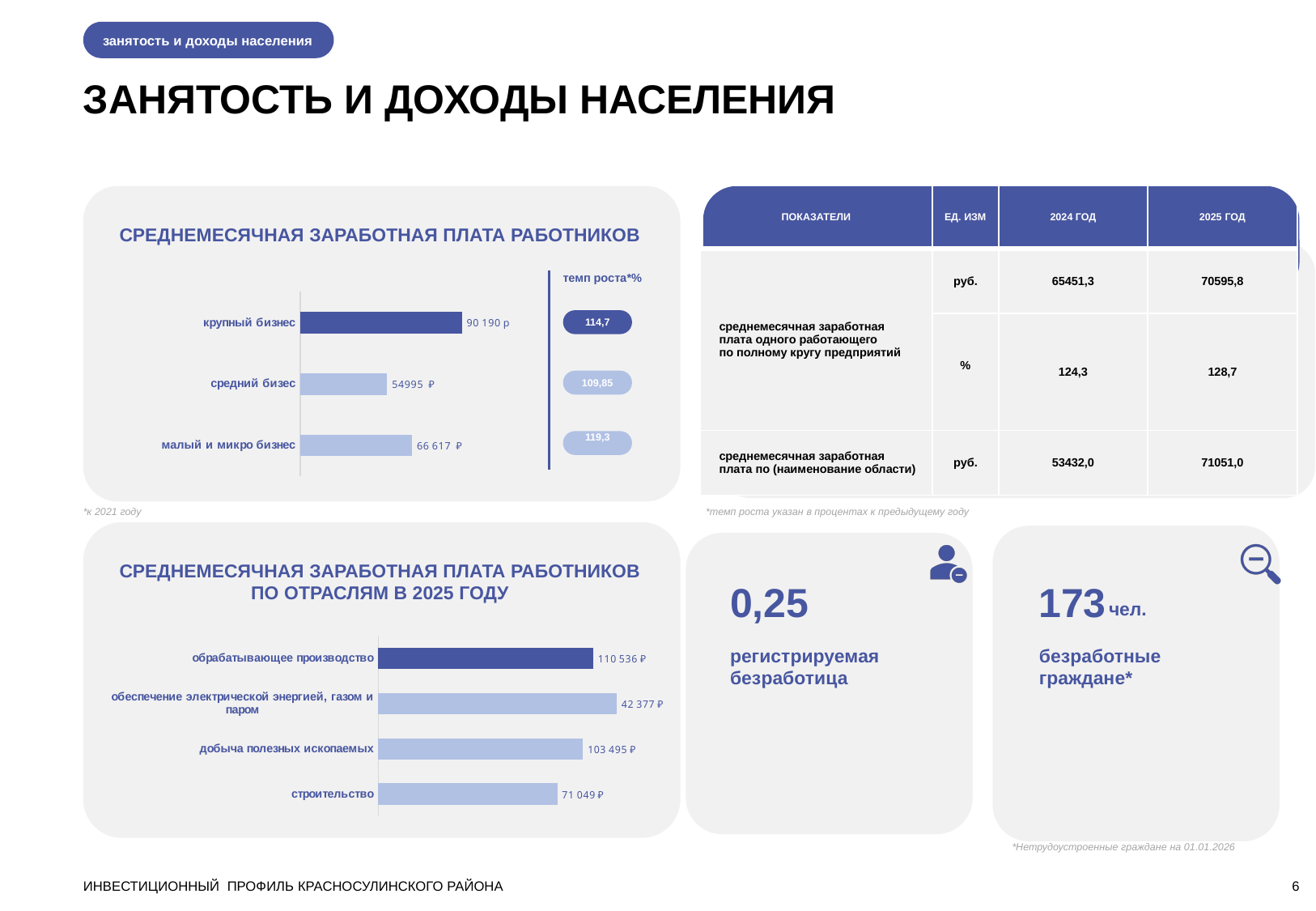
What kind of chart is 'СРЕДНЕМЕСЯЧНАЯ ЗАРАБОТНАЯ ПЛАТА РАБОТНИКОВ ПО ОТРАСЛЯМ В 2025 ГОДУ'? bar chart On the chart 'СРЕДНЕМЕСЯЧНАЯ ЗАРАБОТНАЯ ПЛАТА РАБОТНИКОВ', what is the 'темп роста' value shown for 'малый и микро бизнес'? 119,3 On the chart 'СРЕДНЕМЕСЯЧНАЯ ЗАРАБОТНАЯ ПЛАТА РАБОТНИКОВ ПО ОТРАСЛЯМ В 2025 ГОДУ', which is larger: 'обрабатывающее производство' or 'строительство'? обрабатывающее производство On the chart 'СРЕДНЕМЕСЯЧНАЯ ЗАРАБОТНАЯ ПЛАТА РАБОТНИКОВ', which category has the lowest value? средний бизес On the chart 'СРЕДНЕМЕСЯЧНАЯ ЗАРАБОТНАЯ ПЛАТА РАБОТНИКОВ', what is the value for 'малый и микро бизнес'? 66 617 ₽ On the chart 'СРЕДНЕМЕСЯЧНАЯ ЗАРАБОТНАЯ ПЛАТА РАБОТНИКОВ ПО ОТРАСЛЯМ В 2025 ГОДУ', how many industries are plotted? 4 On the chart 'СРЕДНЕМЕСЯЧНАЯ ЗАРАБОТНАЯ ПЛАТА РАБОТНИКОВ ПО ОТРАСЛЯМ В 2025 ГОДУ', what is the value for 'строительство'? 71 049 ₽ On the chart 'СРЕДНЕМЕСЯЧНАЯ ЗАРАБОТНАЯ ПЛАТА РАБОТНИКОВ', what is the value for 'крупный бизнес'? 90 190 р On the chart 'СРЕДНЕМЕСЯЧНАЯ ЗАРАБОТНАЯ ПЛАТА РАБОТНИКОВ', what is the difference between 'крупный бизнес' and 'малый и микро бизнес'? 23 573 On the chart 'СРЕДНЕМЕСЯЧНАЯ ЗАРАБОТНАЯ ПЛАТА РАБОТНИКОВ', how many categories are plotted? 3 On the chart 'СРЕДНЕМЕСЯЧНАЯ ЗАРАБОТНАЯ ПЛАТА РАБОТНИКОВ', which category has the highest value? крупный бизнес On the chart 'СРЕДНЕМЕСЯЧНАЯ ЗАРАБОТНАЯ ПЛАТА РАБОТНИКОВ ПО ОТРАСЛЯМ В 2025 ГОДУ', what is the value for 'добыча полезных ископаемых'? 103 495 ₽